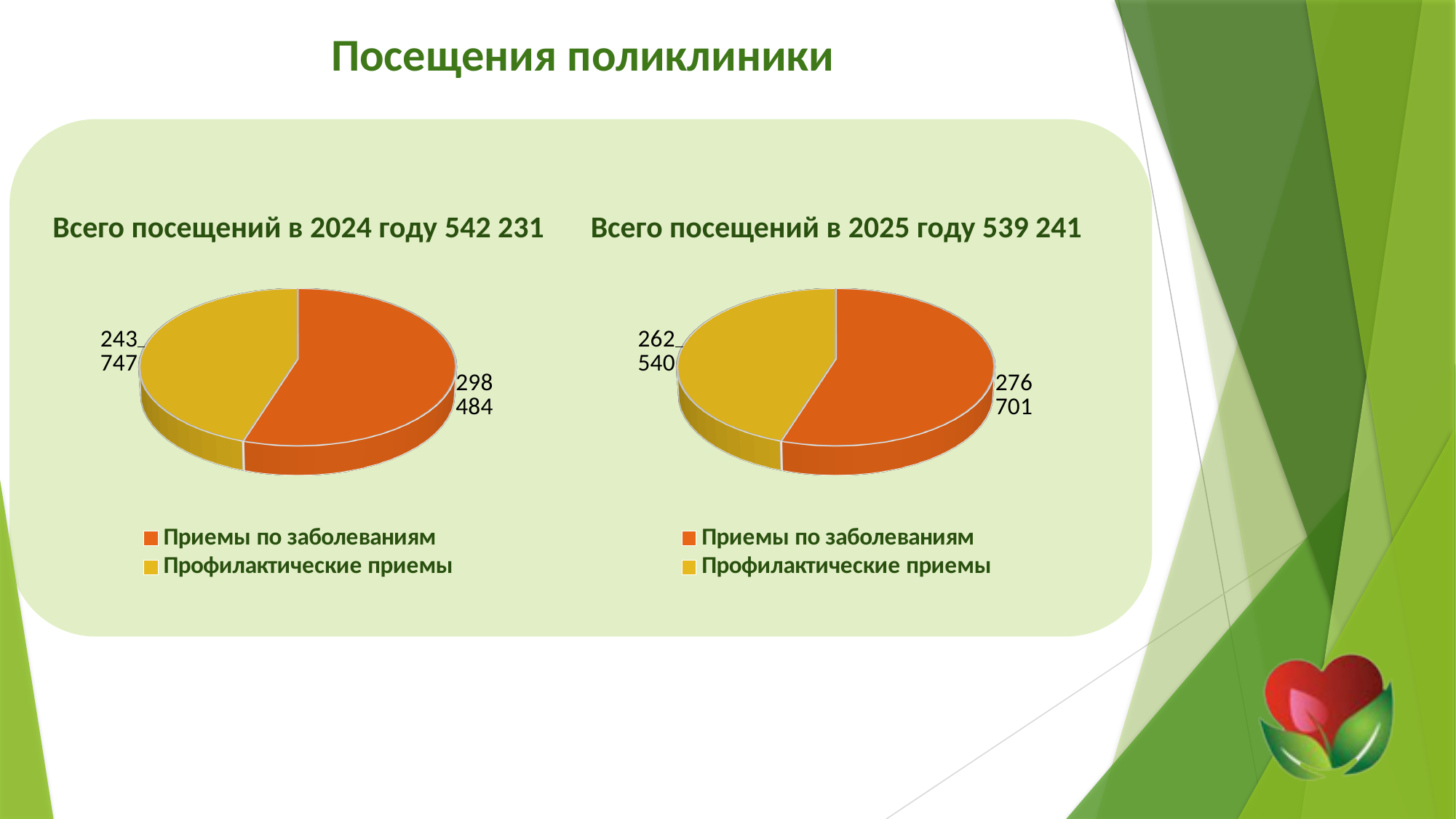
How many categories does the legend of the left chart (2024) list? 2 What type of chart is used on this slide? Pie chart In the left chart (2024), what is the difference between "Приемы по заболеваниям" and "Профилактические приемы"? 54 737 In the chart titled "Всего посещений в 2024 году 542 231", what is the value for "Приемы по заболеваниям"? 298 484 In the chart titled "Всего посещений в 2025 году 539 241", what is the value for "Профилактические приемы"? 262 540 In the left chart (2024), what share of the total do "Приемы по заболеваниям" make up, to the nearest percent? 55% In the left chart (2024), which category has the larger value? Приемы по заболеваниям In the right chart (2025), what is the difference between "Приемы по заболеваниям" and "Профилактические приемы"? 14 161 Is the value for "Приемы по заболеваниям" larger in the 2024 chart or in the 2025 chart? 2024 In the chart titled "Всего посещений в 2025 году 539 241", what is the value for "Приемы по заболеваниям"? 276 701 In the right chart (2025), which category has the smaller value? Профилактические приемы In the chart titled "Всего посещений в 2024 году 542 231", what is the value for "Профилактические приемы"? 243 747